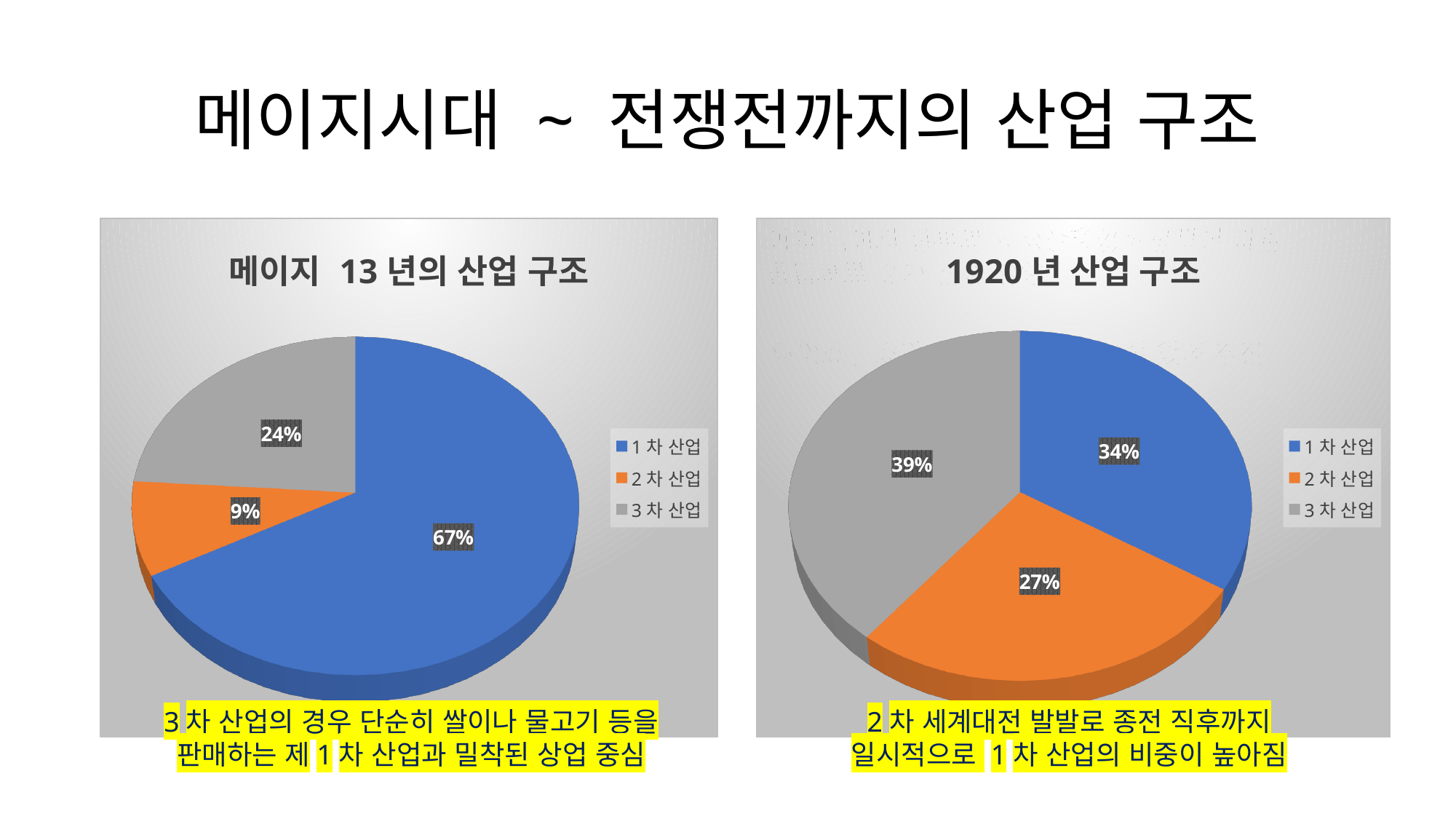
In the chart titled '메이지 13 년의 산업 구조', which colour represents 2 차 산업? Orange How many categories does the legend of the chart titled '메이지 13 년의 산업 구조' list? 3 In the chart titled '메이지 13 년의 산업 구조', what share does 1 차 산업 have? 67% In the chart titled '메이지 13 년의 산업 구조', what share does 2 차 산업 have? 9% In the chart titled '1920 년 산업 구조', which is larger, the share of 1 차 산업 or 2 차 산업? 1 차 산업 In the chart titled '1920 년 산업 구조', what share does 2 차 산업 have? 27% What kind of chart is the chart titled '1920 년 산업 구조'? Pie chart In the chart titled '1920 년 산업 구조', what share does 3 차 산업 have? 39% In the chart titled '메이지 13 년의 산업 구조', which category has the largest slice? 1 차 산업 In the chart titled '메이지 13 년의 산업 구조', what is the difference between the shares of 1 차 산업 and 3 차 산업? 43% In the chart titled '1920 년 산업 구조', which category has the largest slice? 3 차 산업 In the chart titled '1920 년 산업 구조', which category has the smallest slice? 2 차 산업